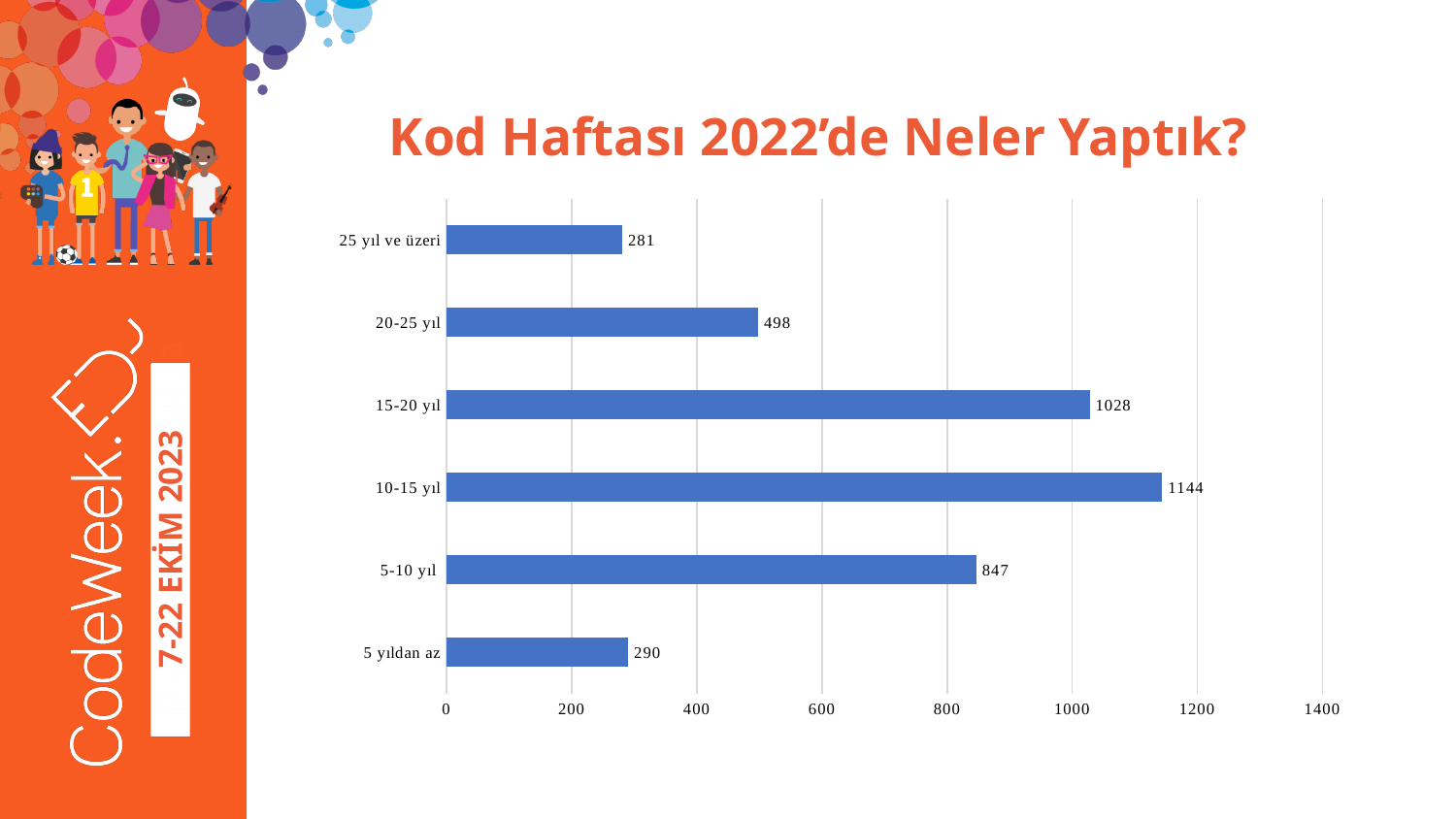
What kind of chart is shown on the slide? bar chart What is the difference between the values for 5-10 yıl and 20-25 yıl? 349 What is the difference between the values for 10-15 yıl and 15-20 yıl? 116 Is the value for 15-20 yıl greater or less than 1000? greater What is the value for the 10-15 yıl category? 1144 Which category has the highest value? 10-15 yıl What is the value for the 20-25 yıl category? 498 How many categories are shown in the chart? 6 What is the value for the 5 yıldan az category? 290 Which is larger, the value for 5-10 yıl or the value for 20-25 yıl? 5-10 yıl Which category has the lowest value? 25 yıl ve üzeri What is the title of the slide containing the chart? Kod Haftası 2022'de Neler Yaptık?